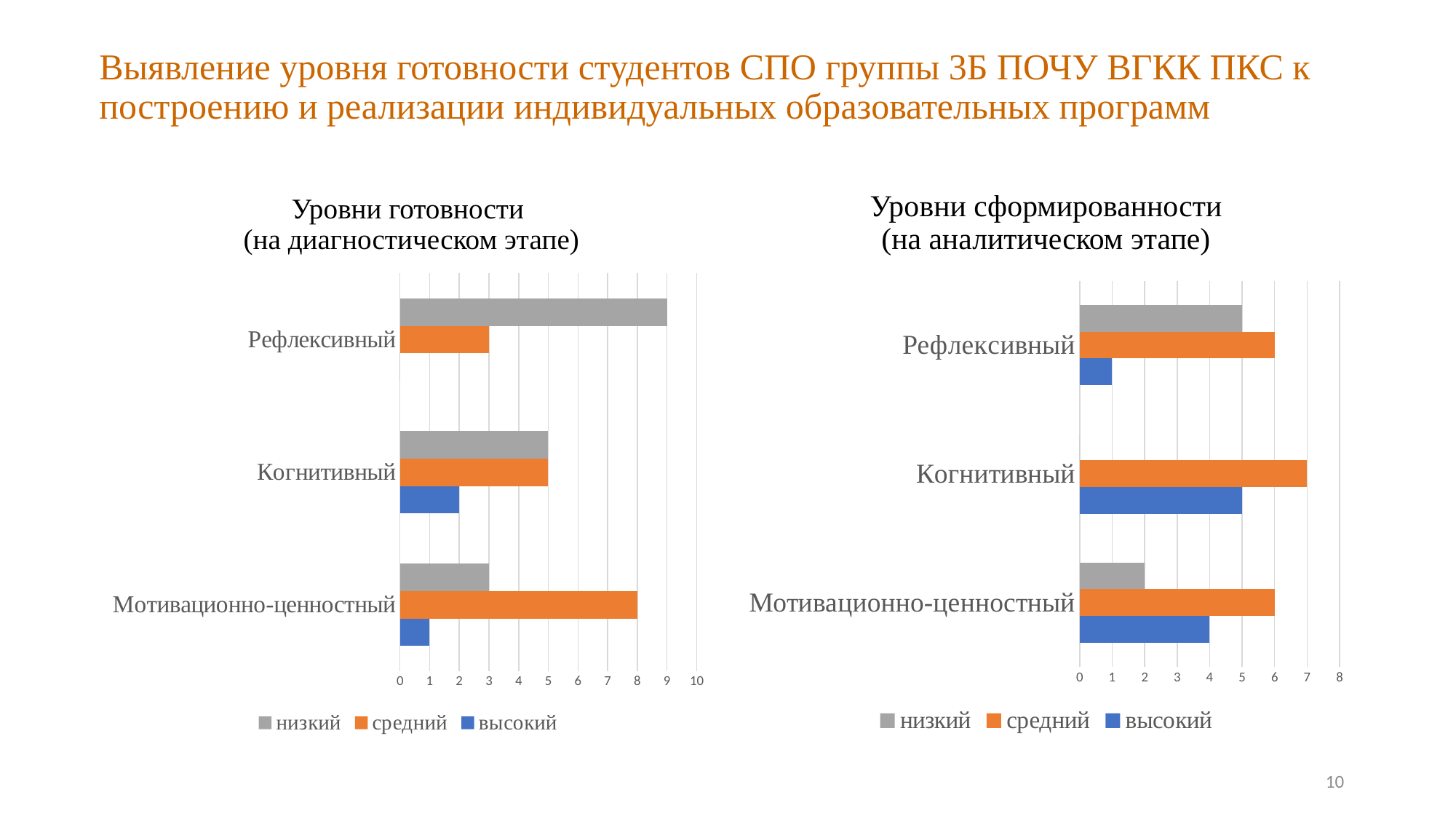
In the right chart 'Уровни сформированности (на аналитическом этапе)', what is the value of 'средний' for 'Когнитивный'? 7 In the left chart 'Уровни готовности (на диагностическом этапе)', which category has the highest 'низкий' value? Рефлексивный In the right chart 'Уровни сформированности (на аналитическом этапе)', what is the value of 'высокий' for 'Мотивационно-ценностный'? 4 How many categories are shown on the y axis of the left chart 'Уровни готовности (на диагностическом этапе)'? 3 In the left chart 'Уровни готовности (на диагностическом этапе)', what is the value of 'средний' for 'Мотивационно-ценностный'? 8 In the left chart 'Уровни готовности (на диагностическом этапе)', what is the difference between the 'средний' value for 'Мотивационно-ценностный' and the 'средний' value for 'Рефлексивный'? 5 What kind of chart is the left chart, 'Уровни готовности (на диагностическом этапе)'? bar chart In the left chart 'Уровни готовности (на диагностическом этапе)', what is the value of 'высокий' for 'Когнитивный'? 2 In the right chart 'Уровни сформированности (на аналитическом этапе)', which is larger: the 'низкий' value for 'Рефлексивный' or the 'низкий' value for 'Мотивационно-ценностный'? Рефлексивный In the right chart 'Уровни сформированности (на аналитическом этапе)', which category has the lowest 'высокий' value? Рефлексивный In the left chart 'Уровни готовности (на диагностическом этапе)', what is the value of 'низкий' for 'Рефлексивный'? 9 How many series does the legend of the right chart 'Уровни сформированности (на аналитическом этапе)' list? 3